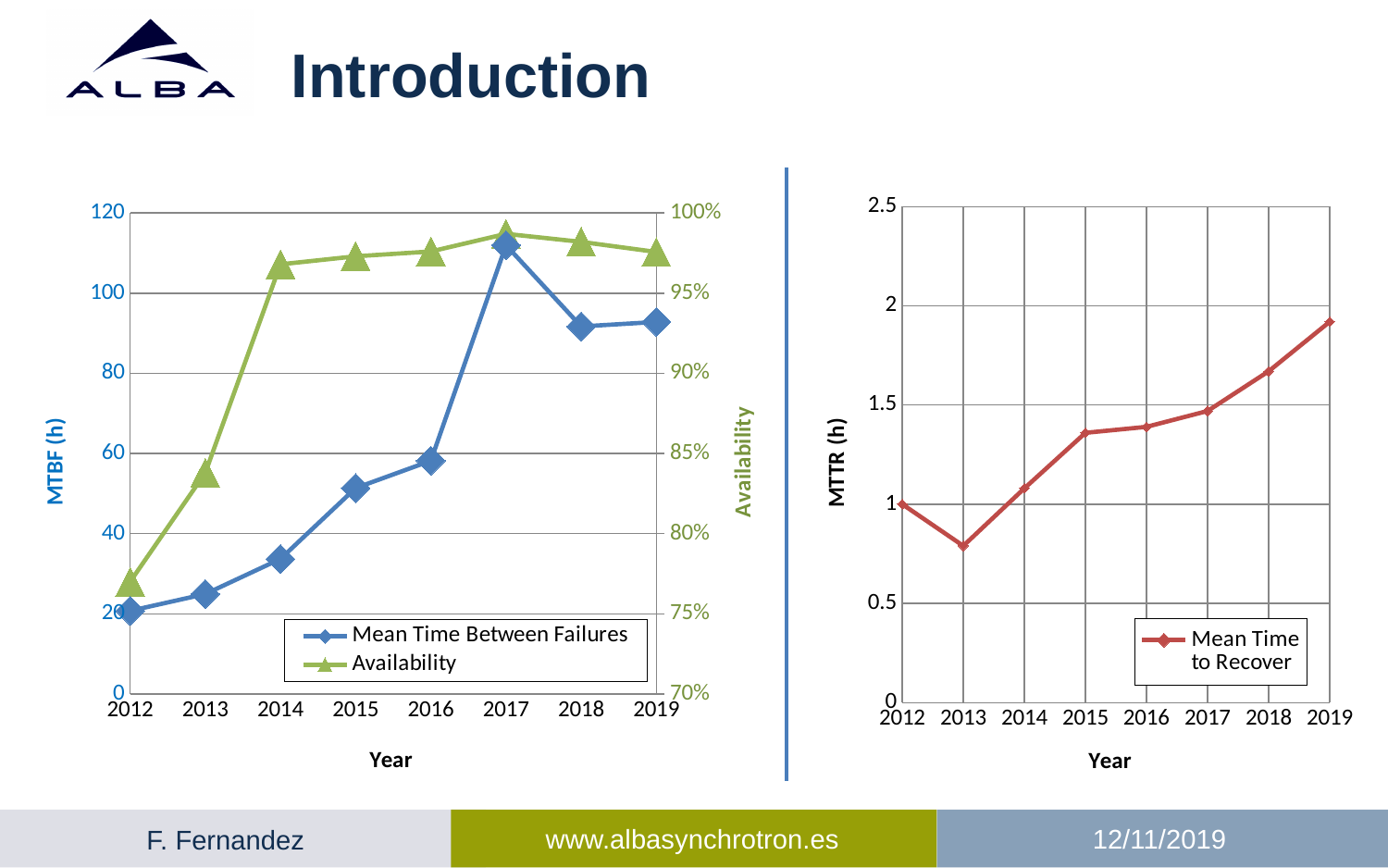
In the right chart, does the Mean Time to Recover rise or fall from 2013 to 2019? rise In the right chart, is the Mean Time to Recover for 2019 greater or less than 1.5? greater In the left chart, is the Availability for 2014 greater or less than 95%? greater In the left chart, which year has the highest Mean Time Between Failures? 2017 In the left chart, which is larger: the Mean Time Between Failures for 2018 or for 2016? 2018 What kind of chart is the right chart (MTTR)? line chart How many series does the legend of the left chart list? 2 In the left chart, is the Mean Time Between Failures for 2015 greater or less than 60? less In the left chart, which year has the lowest Mean Time Between Failures? 2012 In the right chart, which year has the lowest Mean Time to Recover? 2013